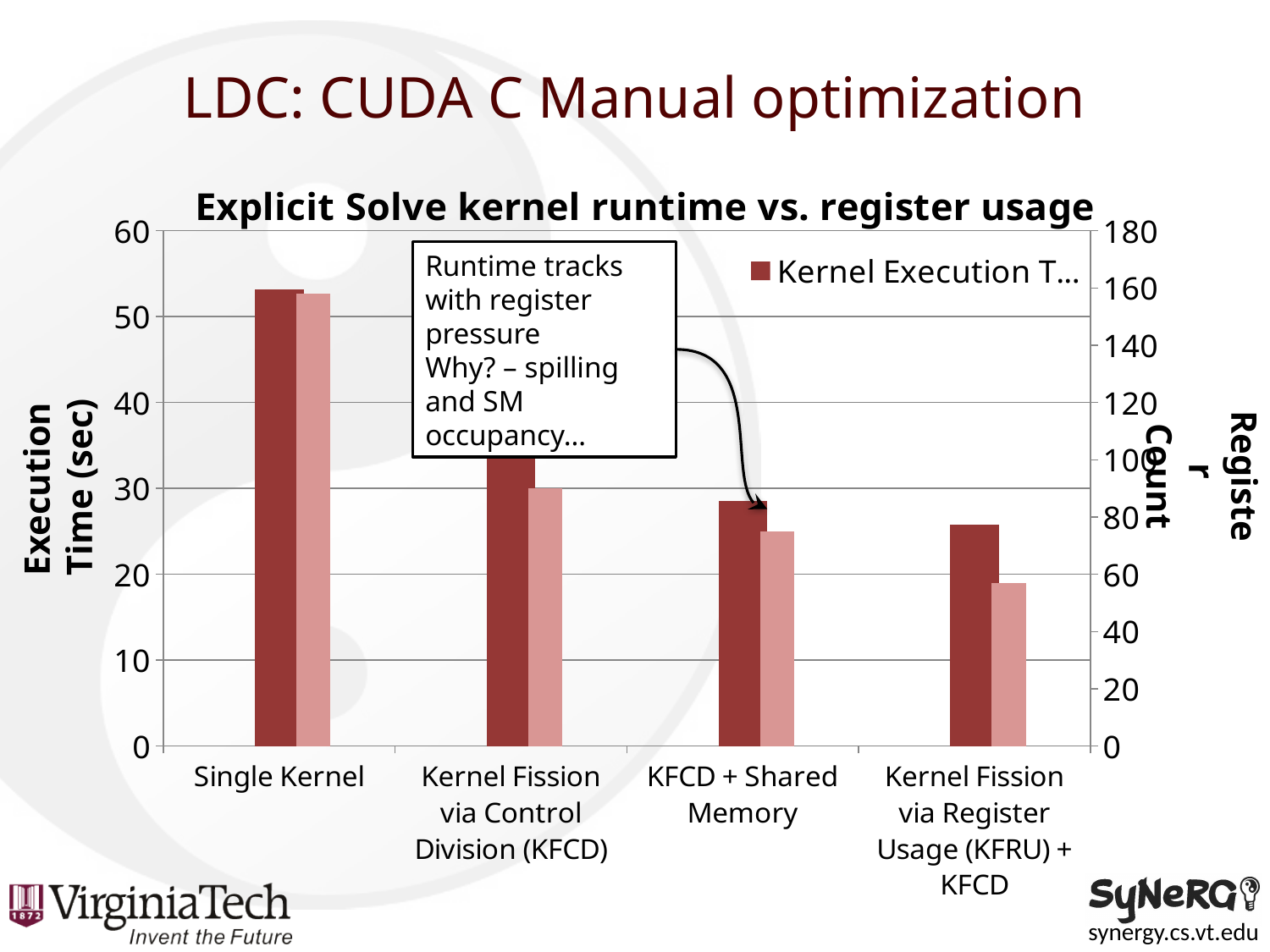
What is the title of the chart? Explicit Solve kernel runtime vs. register usage Is the execution time for KFCD + Shared Memory greater or less than 30 seconds? less Is the execution time for Single Kernel greater or less than 50 seconds? greater Is the register count (light pink bar) for Single Kernel greater or less than 140? greater What kind of chart is shown on the slide? Bar chart Which category has the lowest execution time (dark red bar)? Kernel Fission via Register Usage (KFRU) + KFCD How many bars are plotted for each category in the chart? 2 How many categories are shown on the x axis of the chart? 4 Which category has the highest execution time (dark red bar)? Single Kernel Which has the larger light pink (register count) bar: Kernel Fission via Control Division (KFCD) or KFCD + Shared Memory? Kernel Fission via Control Division (KFCD) Do the execution time bars rise or fall moving left to right across the categories? Fall